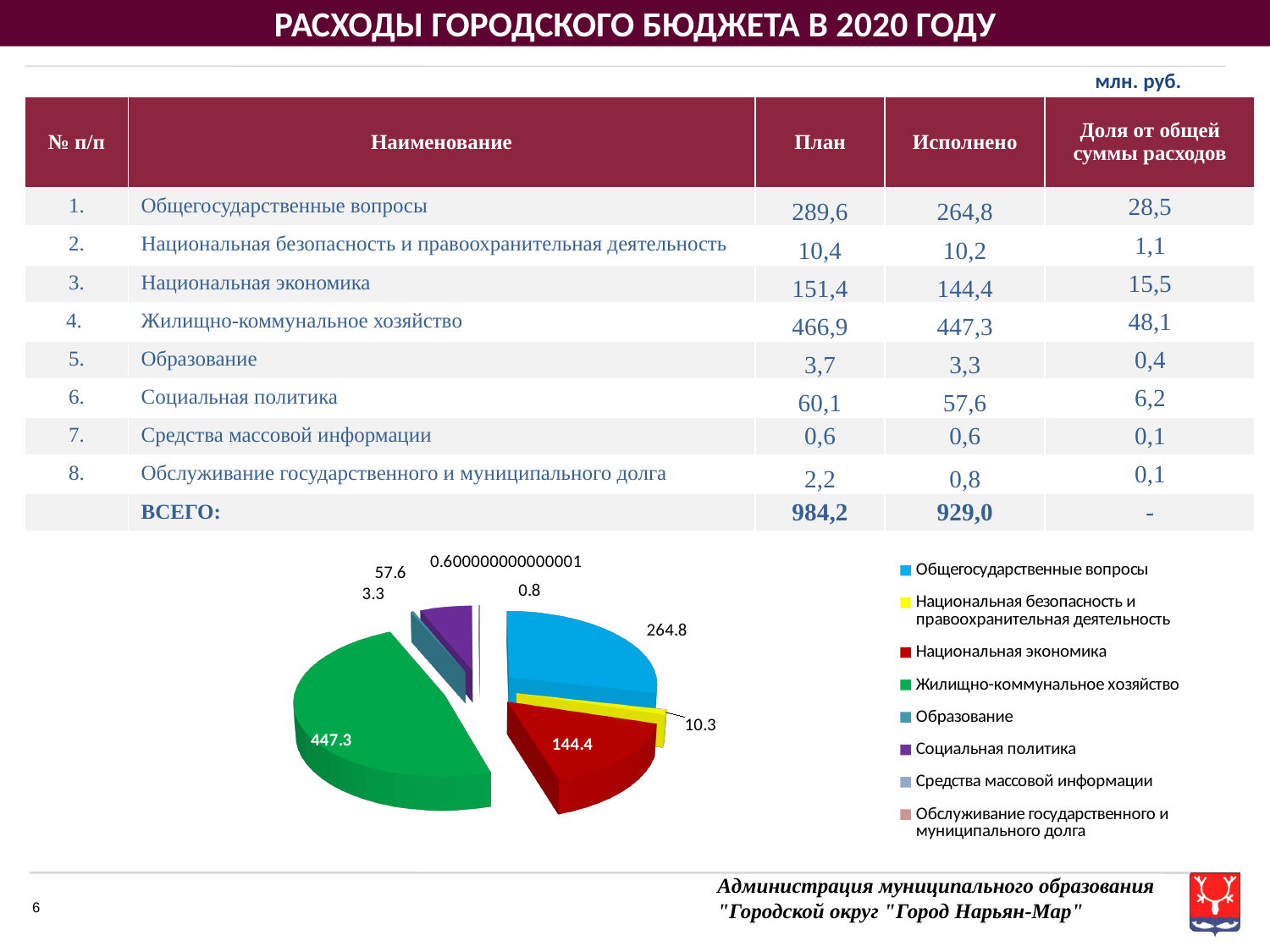
What value is labelled on the pie chart for Жилищно-коммунальное хозяйство? 447.3 What value is labelled on the pie chart for Общегосударственные вопросы? 264.8 Which category has the smallest labelled value in the pie chart? Средства массовой информации What colour is the slice for Жилищно-коммунальное хозяйство in the pie chart? green What value is labelled on the pie chart for Социальная политика? 57.6 What value is labelled on the pie chart for Национальная безопасность и правоохранительная деятельность? 10.3 What is the difference between the pie chart values for Жилищно-коммунальное хозяйство and Общегосударственные вопросы? 182.5 How many entries does the pie chart's legend list? 8 What value is labelled on the pie chart for Национальная экономика? 144.4 Which category has the largest slice in the pie chart? Жилищно-коммунальное хозяйство What kind of chart is shown on the slide? pie chart In the pie chart, which is larger: Общегосударственные вопросы or Национальная экономика? Общегосударственные вопросы